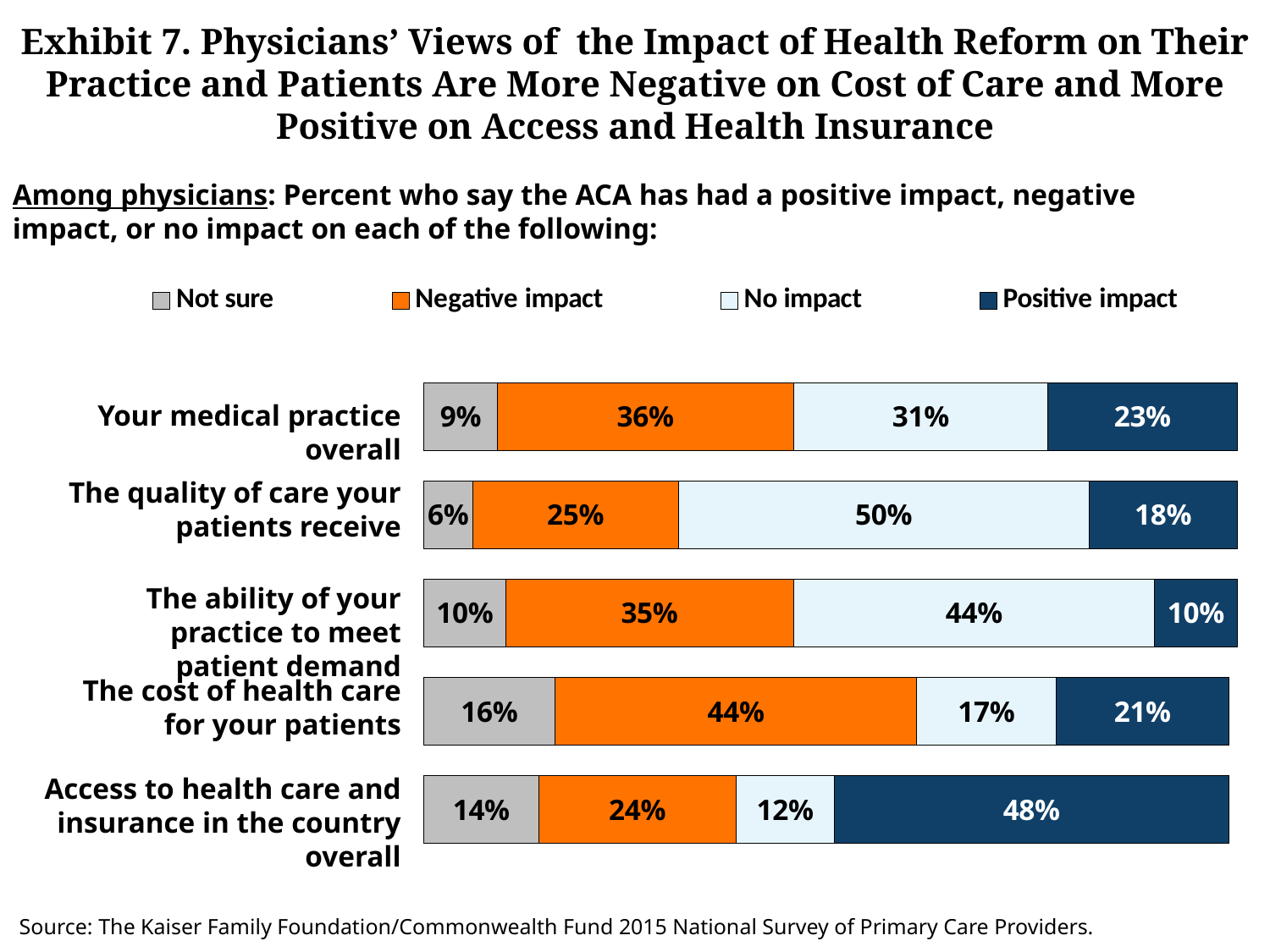
What percent of physicians say the ACA has had a positive impact on access to health care and insurance in the country overall? 48% How many categories are shown in the chart? 5 What is the difference between the negative impact share for the cost of health care for your patients and the negative impact share for access to health care and insurance in the country overall? 20 percentage points What percent of physicians say the ACA has had a negative impact on the cost of health care for their patients? 44% What percent of physicians say the ACA has had no impact on the quality of care their patients receive? 50% Is the negative impact share larger for your medical practice overall or for the quality of care your patients receive? Your medical practice overall Which category has the highest share of physicians reporting a positive impact? Access to health care and insurance in the country overall Which colour represents 'Negative impact' in the legend? Orange How many series does the legend list? 4 What percent of physicians are not sure about the ACA's impact on their medical practice overall? 9% Which category has the lowest share of physicians reporting a positive impact? The ability of your practice to meet patient demand What kind of chart is shown on the slide? Stacked bar chart